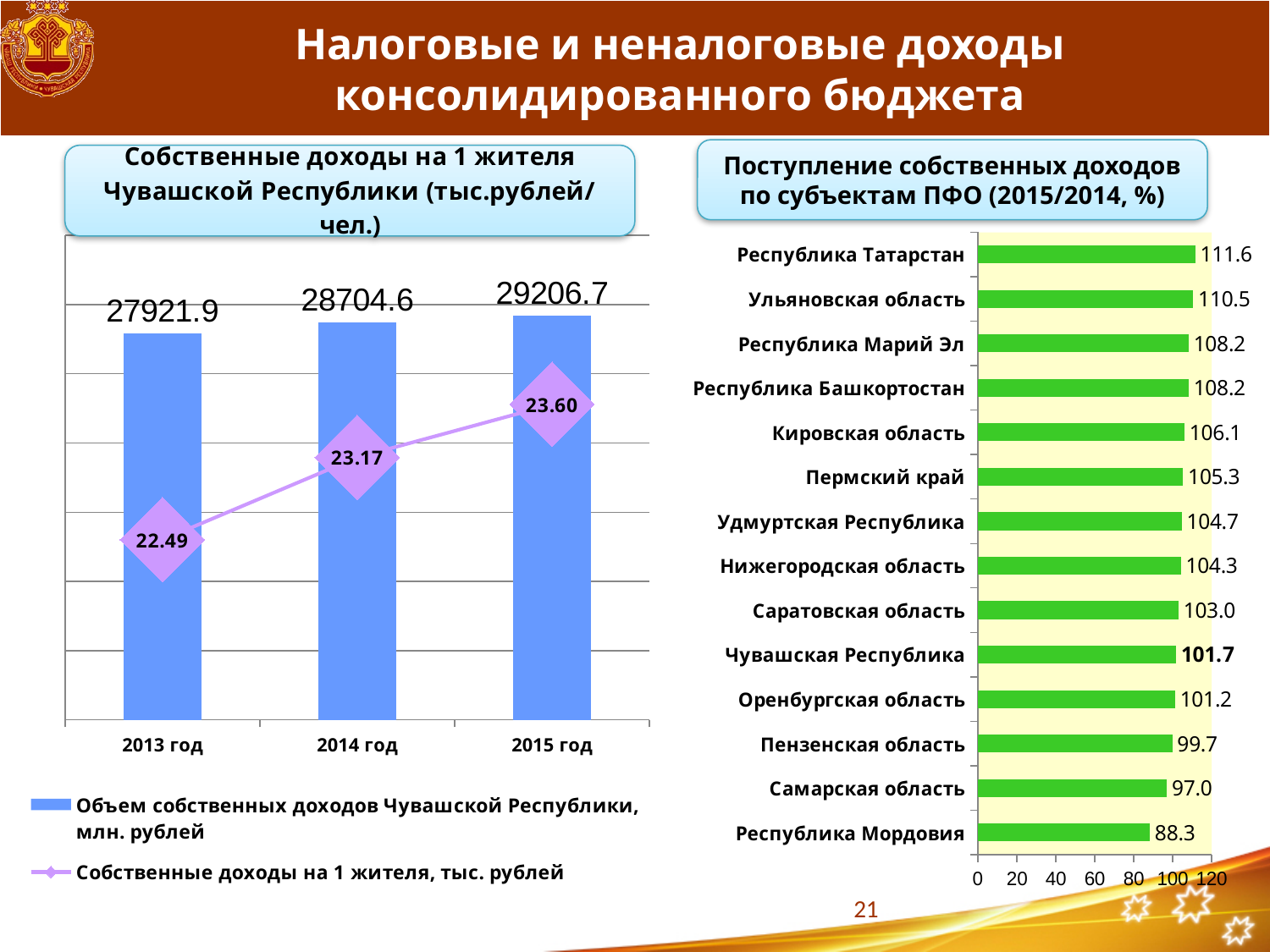
What type of chart is the right chart? bar chart In the right chart, what is the difference between the values for Республика Татарстан and Республика Мордовия? 23.3 How many regions are shown in the right chart? 14 In the right chart (Поступление собственных доходов по субъектам ПФО), which region has the highest value? Республика Татарстан In the left chart, do the line values rise or fall from 2013 год to 2015 год? rise In the right chart, which has a larger value: Кировская область or Пензенская область? Кировская область In the left chart, what is the value of the bar for 2015 год? 29206.7 In the left chart, what is the value of the line marker (Собственные доходы на 1 жителя) for 2013 год? 22.49 In the right chart, which region has the lowest value? Республика Мордовия In the left chart, by how much did the bar value increase from 2013 год to 2014 год? 782.7 How many series does the legend of the left chart list? 2 In the right chart, what is the value for Чувашская Республика? 101.7